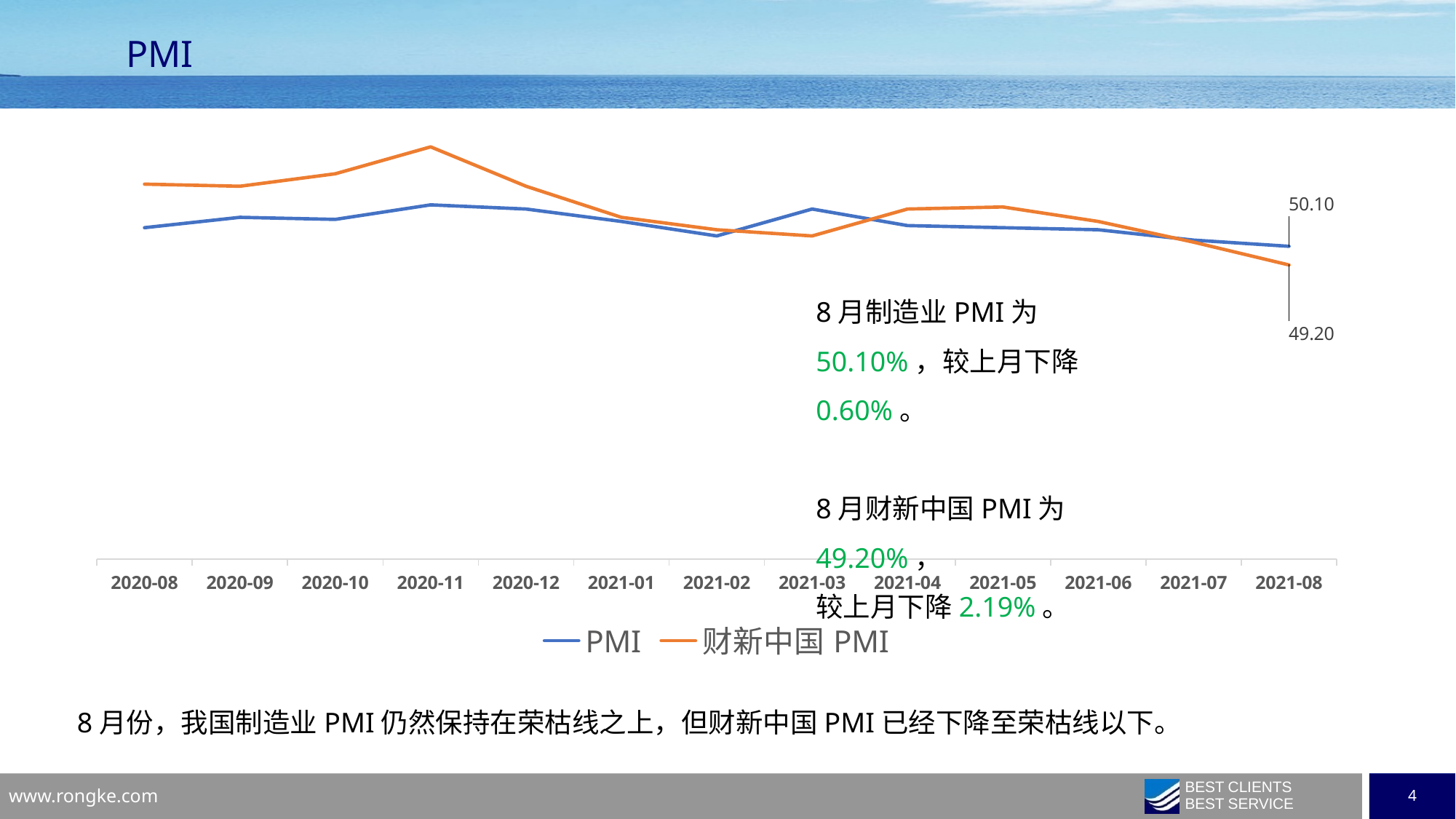
In which month does 财新中国 PMI reach its lowest value? 2021-08 What type of chart is shown on the slide? line chart In which month does 财新中国 PMI reach its highest value? 2020-11 What is the value of 财新中国 PMI at 2021-08? 49.20 At 2021-08, which series has the higher value, PMI or 财新中国 PMI? PMI What is the difference between PMI and 财新中国 PMI at 2021-08? 0.90 How many series does the chart legend list? 2 Does 财新中国 PMI rise or fall from 2021-05 to 2021-08? fall Which colour is used for the 财新中国 PMI line? orange What is the value of PMI at 2021-08? 50.10 How many time points are shown on the x axis of the chart? 13 At 2020-11, which series has the higher value, PMI or 财新中国 PMI? 财新中国 PMI